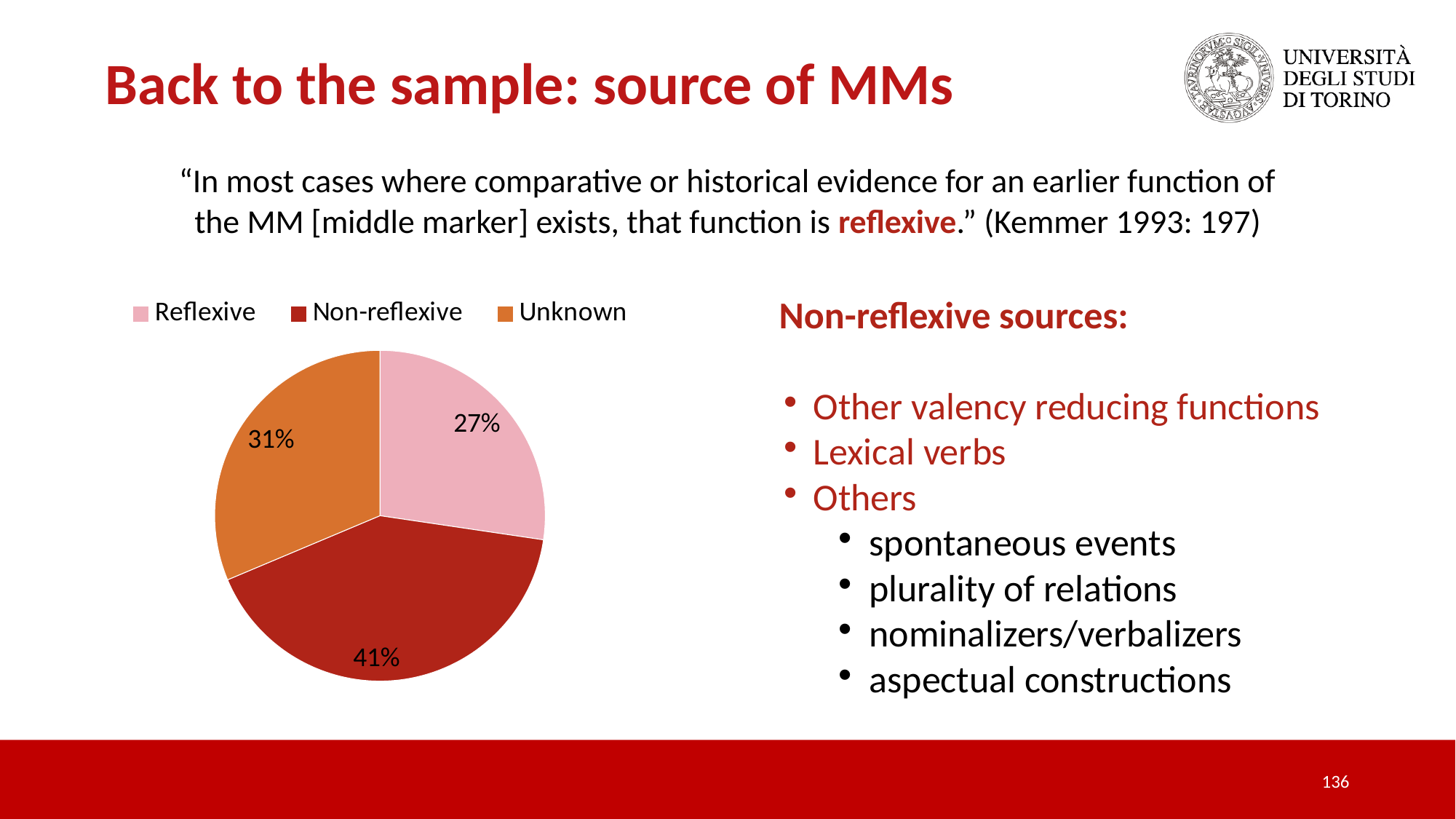
What percentage of the pie chart is labelled Reflexive? 27% How many slices does the pie chart have? 3 Which category has the smallest slice of the pie chart? Reflexive What is the difference in percentage points between the Non-reflexive and Reflexive slices? 14 Which category has the largest slice of the pie chart? Non-reflexive Which slice is larger, Unknown or Reflexive? Unknown What kind of chart is shown on the slide? pie chart How many entries does the legend of the pie chart list? 3 What percentage of the pie chart is labelled Non-reflexive? 41% What is the difference in percentage points between the Unknown and Reflexive slices? 4 What colour is the Unknown slice in the pie chart? orange What percentage of the pie chart is labelled Unknown? 31%